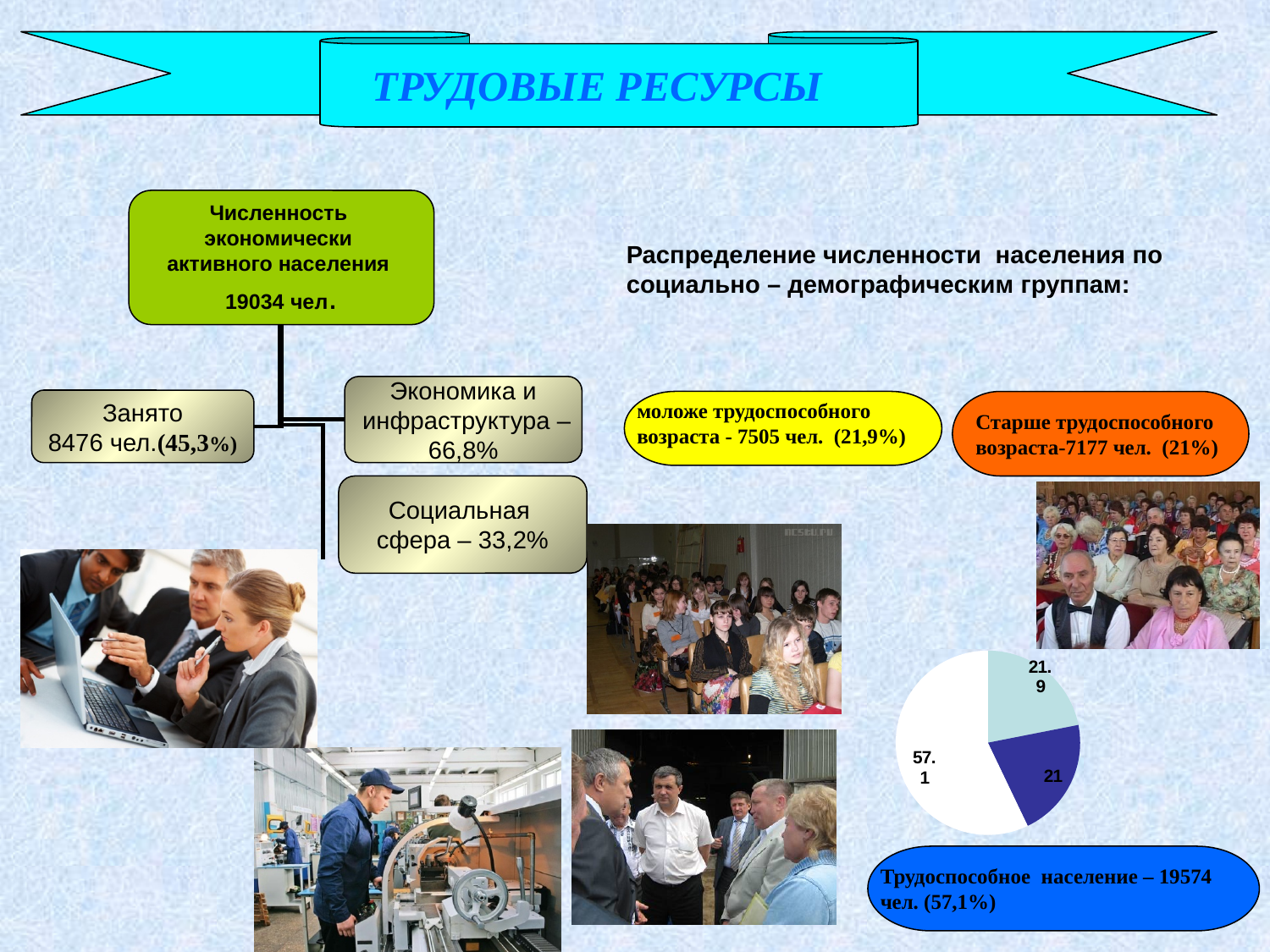
What value is labelled on the white slice of the pie chart? 57.1 What is the value labelled on the largest slice of the pie chart? 57.1 What is the value labelled on the smallest slice of the pie chart? 21 What value is labelled on the light teal slice of the pie chart? 21.9 What value is labelled on the dark blue slice of the pie chart? 21 According to the slide text, which population group does the 57.1 slice of the pie chart represent? Трудоспособное население What kind of chart is shown at the bottom right of the slide? pie chart How many slices does the pie chart have? 3 What is the difference between the light teal slice value and the dark blue slice value in the pie chart? 0.9 Which slice of the pie chart is larger, the light teal one or the dark blue one? the light teal one What is the difference between the largest and smallest slice values in the pie chart? 36.1 Does the pie chart include a legend? No